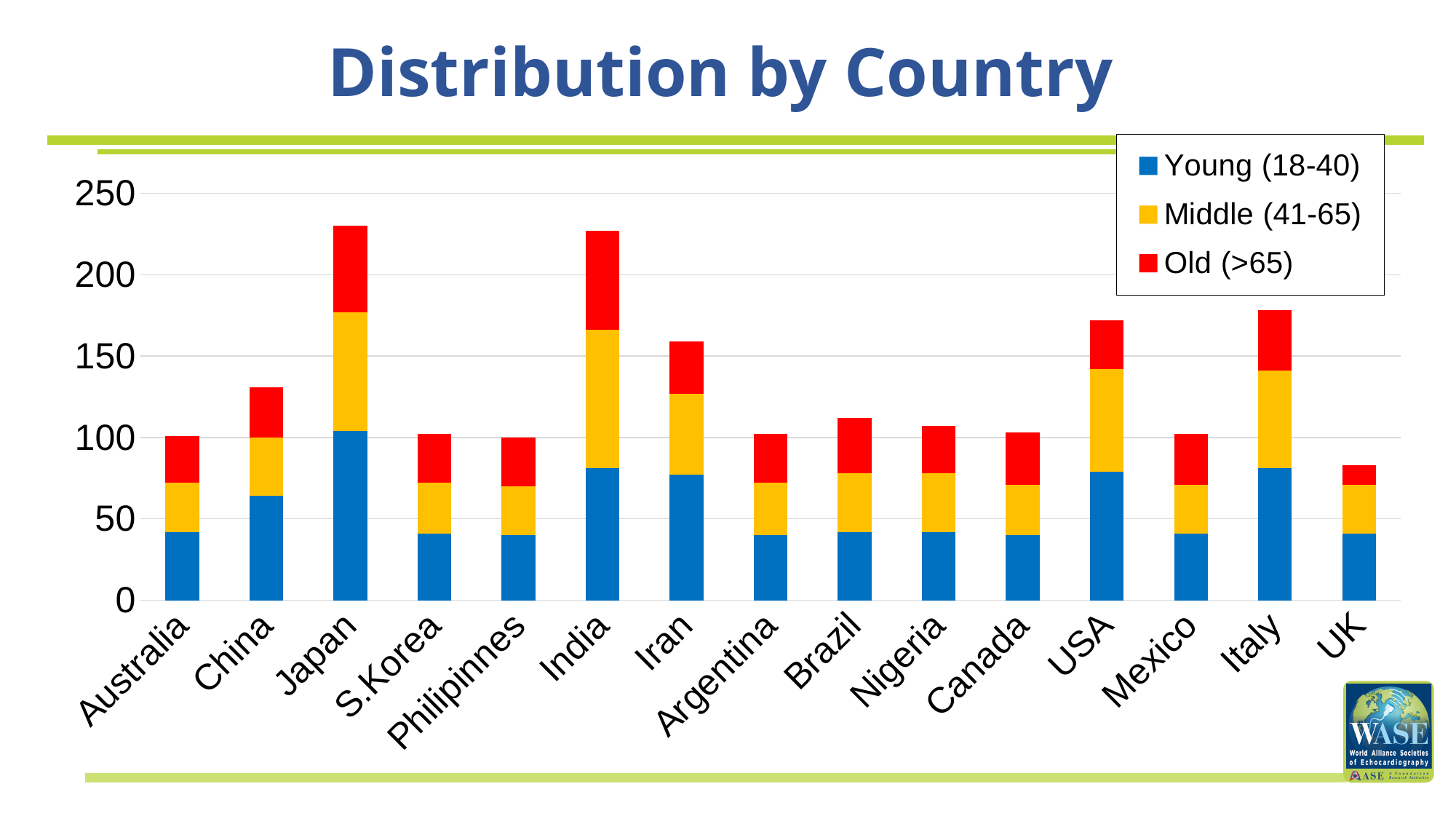
How many countries are shown on the x axis of the chart? 15 What is the title of the chart? Distribution by Country How many series does the legend list? 3 Which has the larger total bar, USA or China? USA Which age group does the red segment represent according to the legend? Old (>65) What kind of chart is shown on the slide? Stacked bar chart Which has the larger total bar, Italy or Brazil? Italy Is the total value for Japan greater or less than 200? greater Is the total value for USA greater or less than 150? greater Is the Young (18-40) value for China greater or less than 50? greater Which country has the lowest total bar? UK